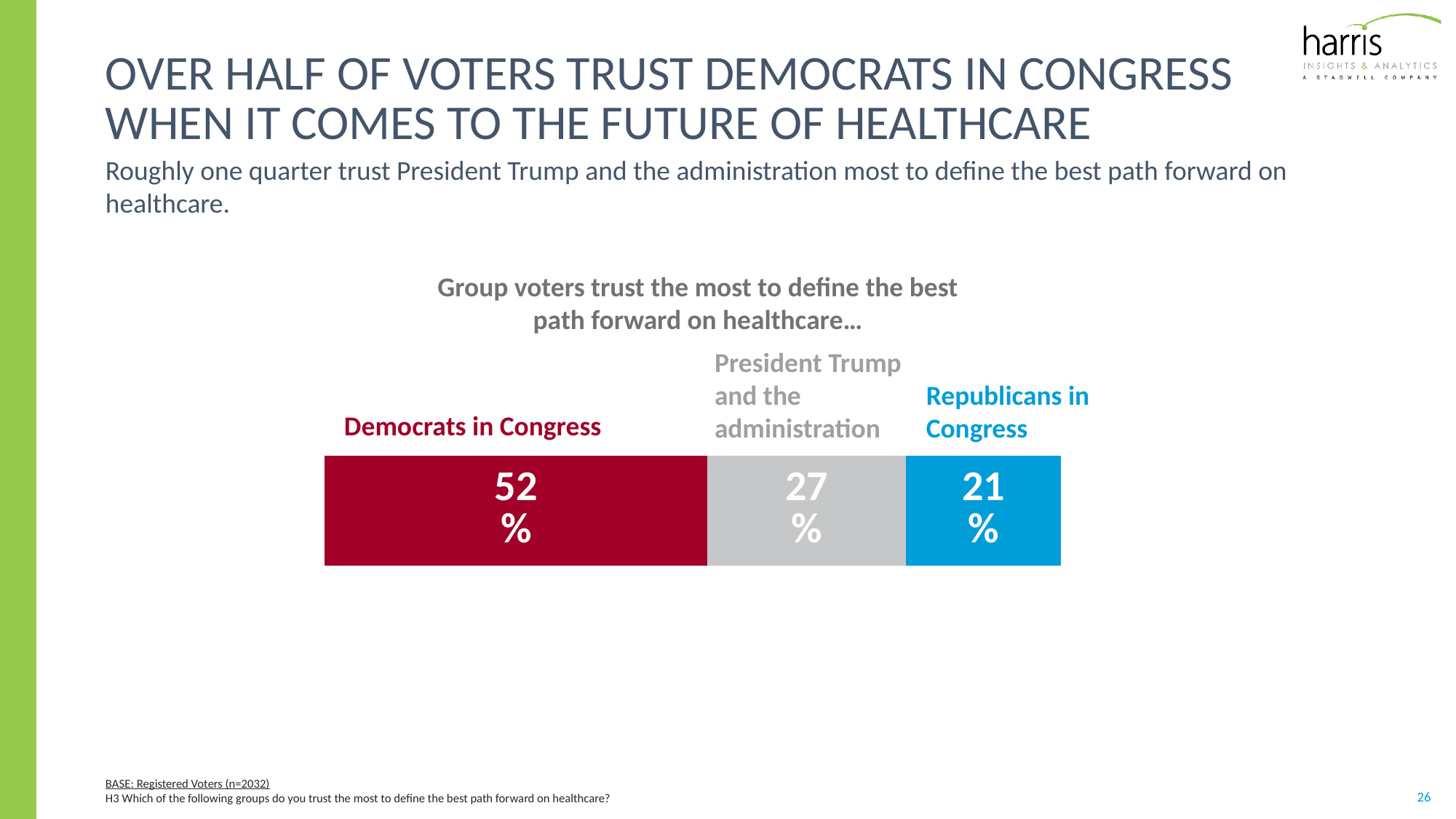
What is the total of the three segments in the stacked bar? 100% How many groups are shown in the chart? 3 What is the difference in percentage points between President Trump and the administration and Republicans in Congress? 6 percentage points Which group do the most voters trust to define the best path forward on healthcare? Democrats in Congress What percentage of voters trust Republicans in Congress the most to define the best path forward on healthcare? 21% What kind of chart is shown on the slide? Stacked bar chart What is the difference in percentage points between Democrats in Congress and Republicans in Congress? 31 percentage points What percentage of voters trust Democrats in Congress the most to define the best path forward on healthcare? 52% What colour is the segment for Republicans in Congress? Blue Which group do the fewest voters trust to define the best path forward on healthcare? Republicans in Congress Which is larger: the share trusting President Trump and the administration or the share trusting Republicans in Congress? President Trump and the administration What percentage of voters trust President Trump and the administration the most to define the best path forward on healthcare? 27%